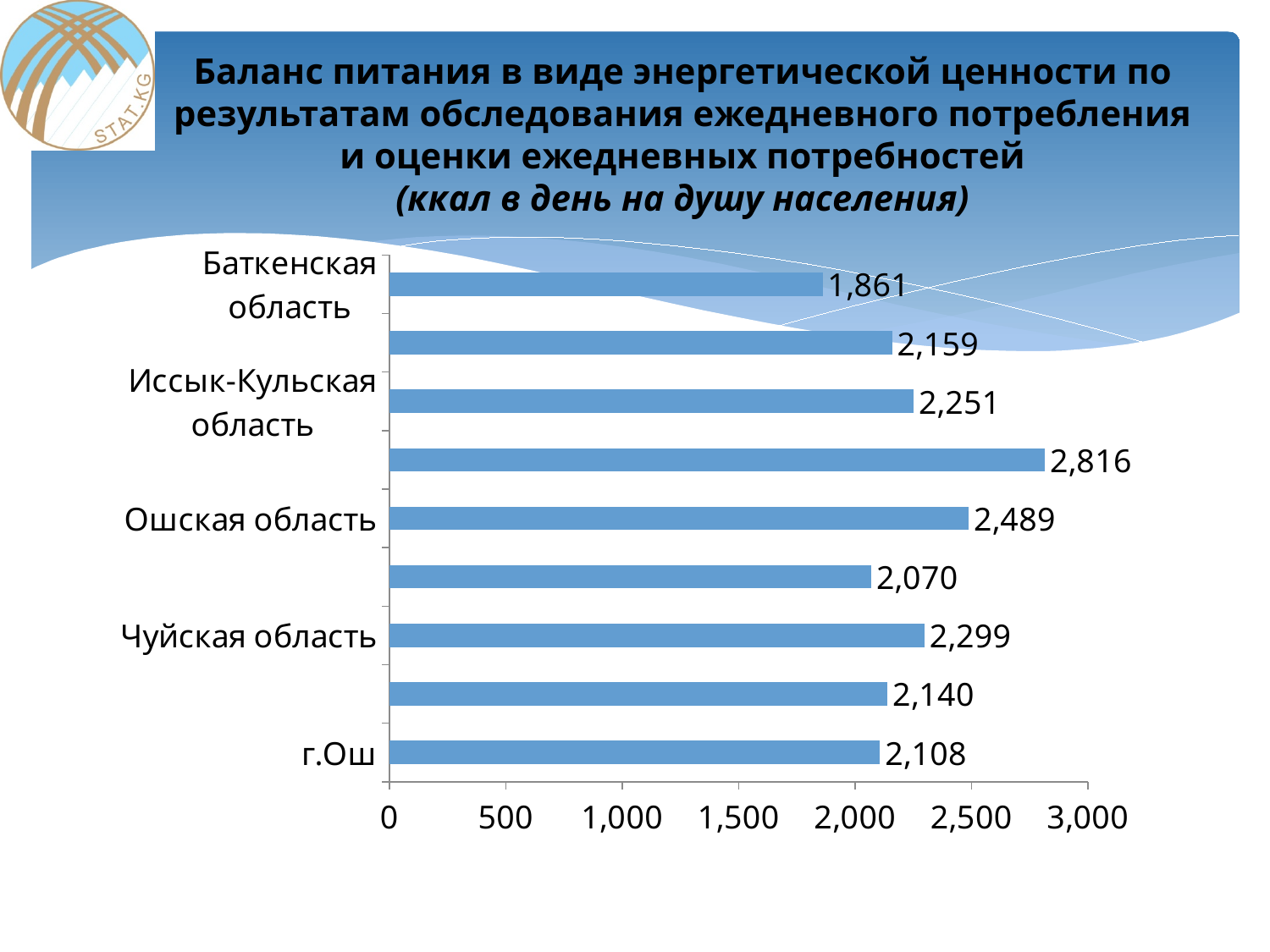
Is the value for Ошская область greater or less than 2,000? greater What is the value for г.Ош? 2,108 Is the value for Баткенская область greater or less than 2,000? less What is the value for Ошская область? 2,489 What is the difference between the values for Ошская область and Баткенская область? 628 What is the value for Чуйская область? 2,299 What kind of chart is shown on the slide? bar chart What is the difference between the values for Чуйская область and г.Ош? 191 Which is larger, the value for Иссык-Кульская область or the value for Чуйская область? Чуйская область What is the value for Иссык-Кульская область? 2,251 What is the value for Баткенская область? 1,861 How many bars are plotted in the chart? 9